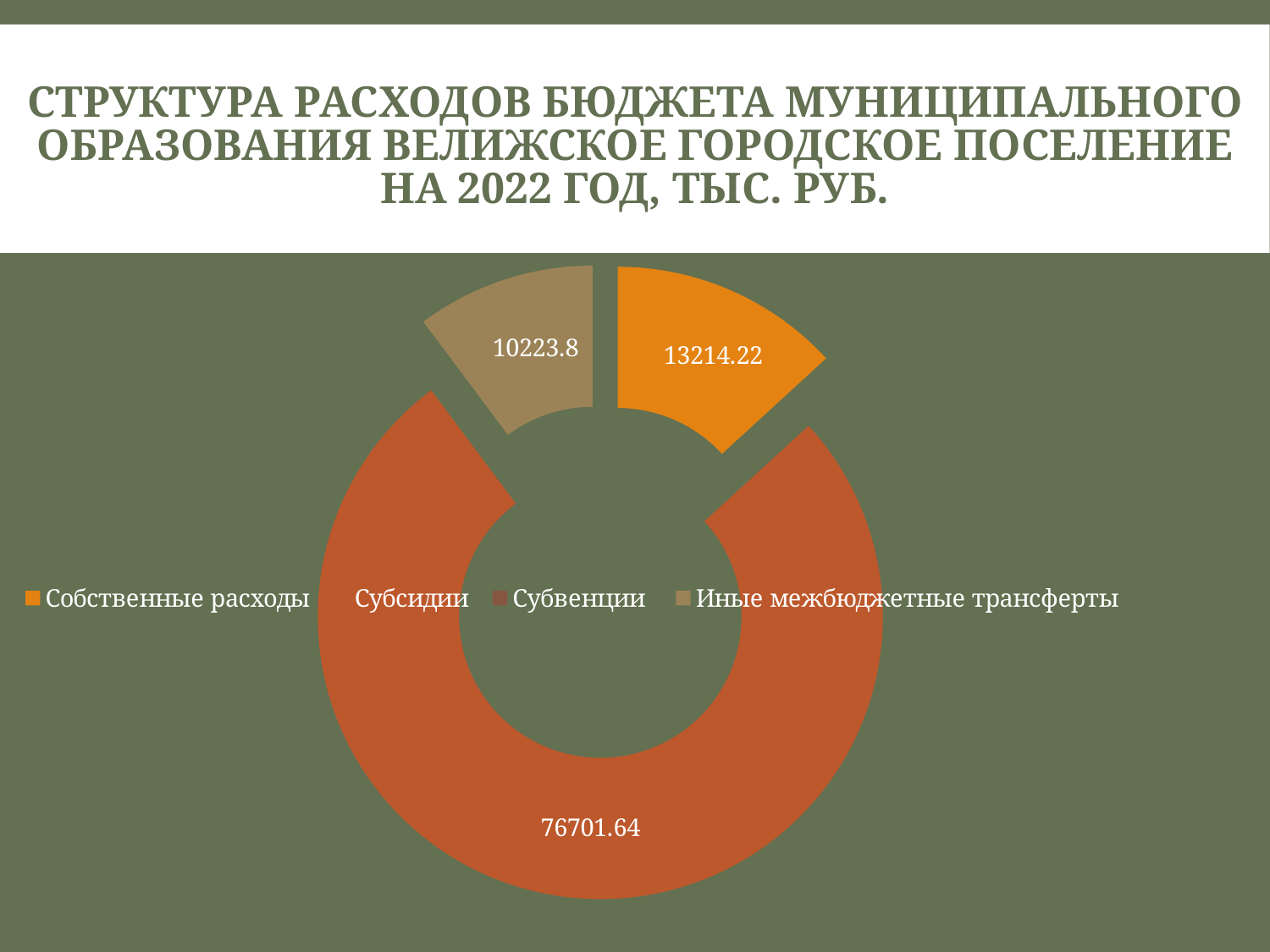
What is the value shown for Субвенции? 76701.64 How many data labels are printed on the chart? 3 Which labelled slice has the smallest value? Иные межбюджетные трансферты What unit is stated in the chart title? тыс. руб. What kind of chart is shown on the slide? doughnut chart Which is larger, Собственные расходы or Иные межбюджетные трансферты? Собственные расходы What is the difference between the values for Собственные расходы and Иные межбюджетные трансферты? 2990.42 What is the value shown for Иные межбюджетные трансферты? 10223.8 How many entries does the legend list? 4 Which category has the largest slice? Субвенции What is the value shown for Собственные расходы? 13214.22 What is the difference between the values for Субвенции and Собственные расходы? 63487.42